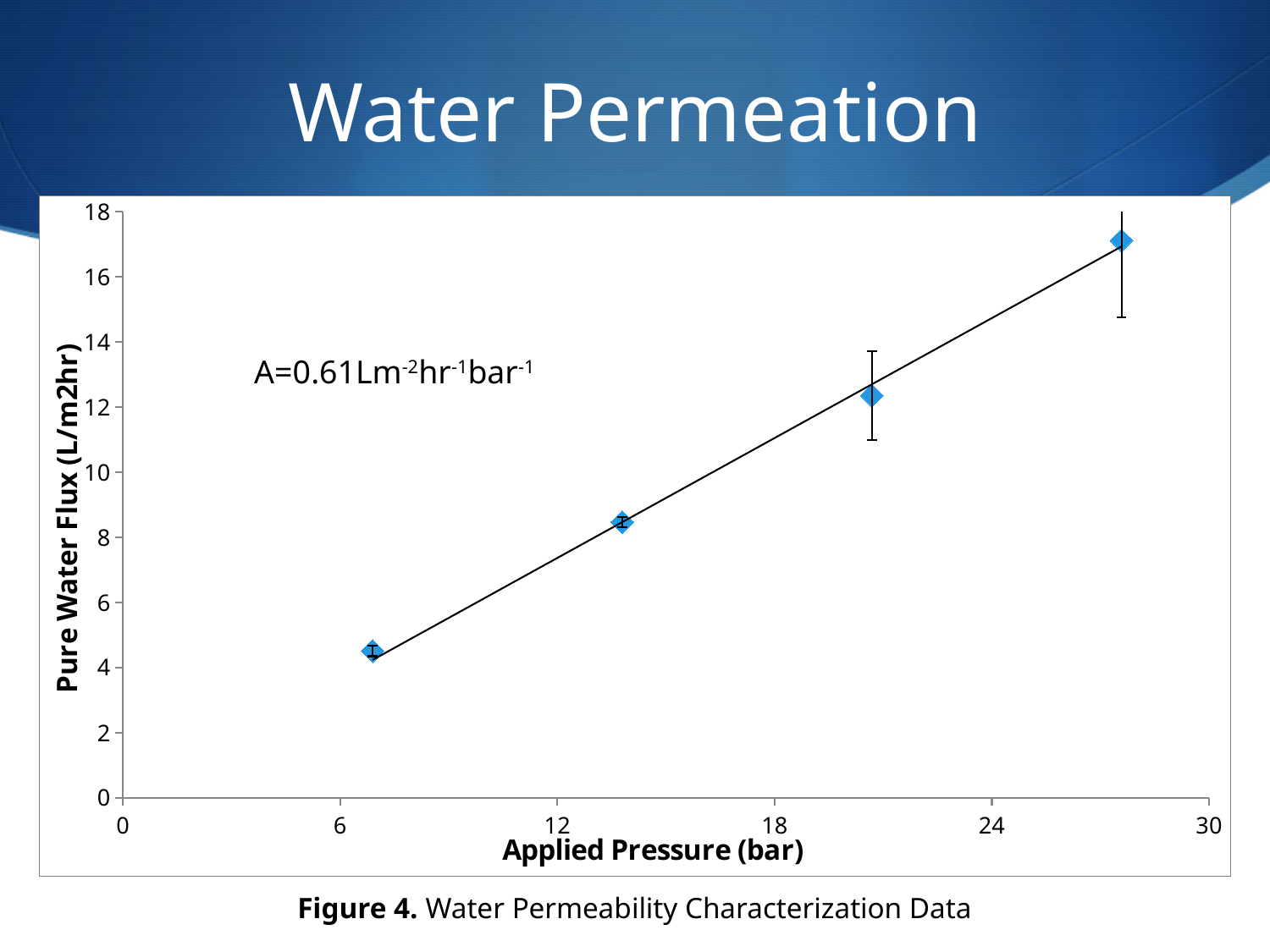
Is the pure water flux for the third data point (around 20 bar) greater or less than 10 L/m2hr? greater What is the maximum value shown on the y axis? 18 What is the label of the y axis? Pure Water Flux (L/m2hr) Is the pure water flux for the second data point (around 14 bar) greater or less than 10 L/m2hr? less How many data points are plotted on the chart? 4 Is the pure water flux at the lowest applied pressure greater or less than 6 L/m2hr? less What is the label of the x axis? Applied Pressure (bar) Which data point has the highest pure water flux: the one at the lowest applied pressure or the one at the highest applied pressure? the one at the highest applied pressure What kind of chart is shown on the slide? scatter chart Does the pure water flux rise or fall as applied pressure increases along the x axis? rise